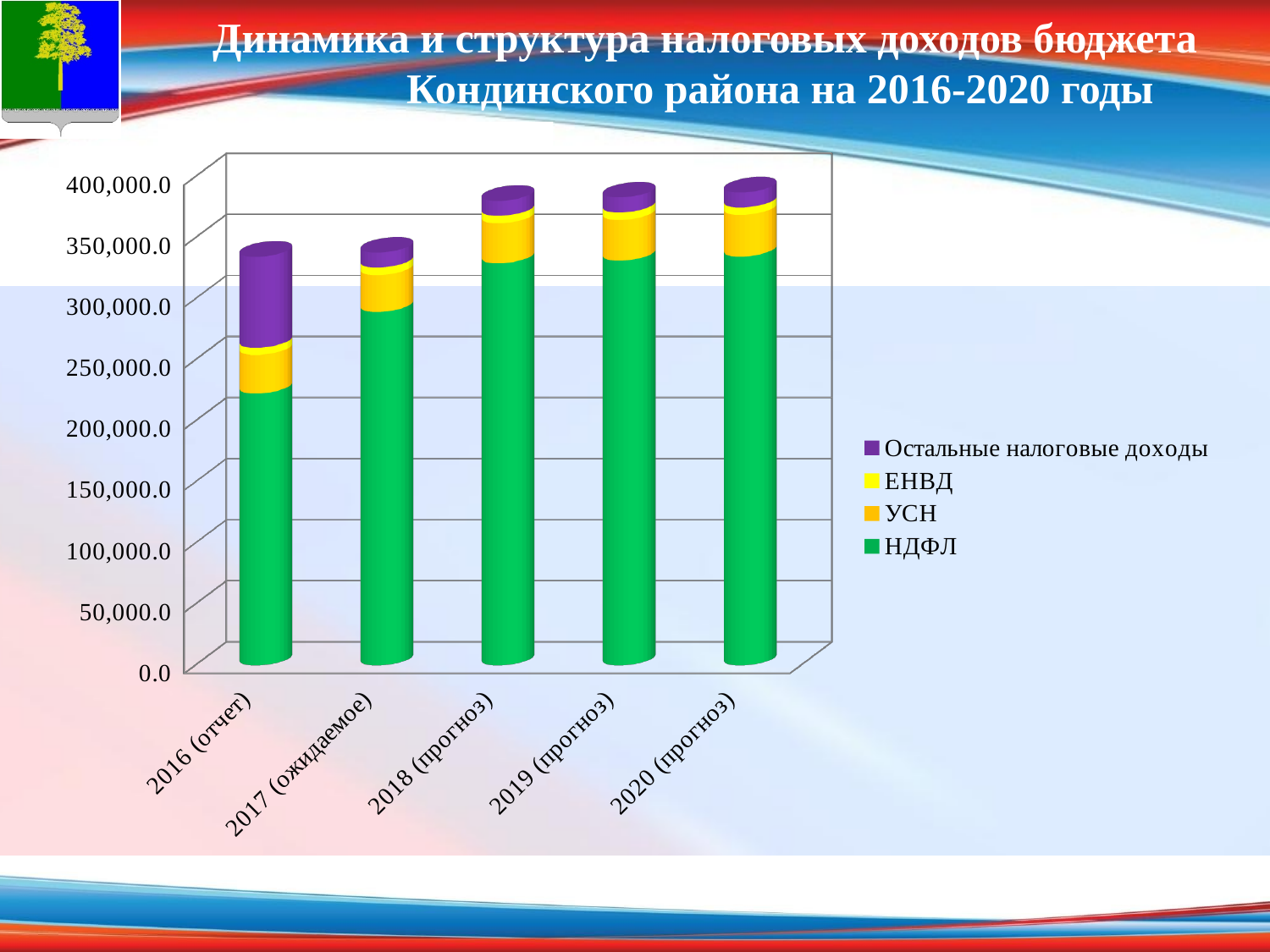
Is the НДФЛ value for 2020 (прогноз) greater or less than 300,000.0? greater Is the НДФЛ value for 2016 (отчет) greater or less than 250,000.0? less What kind of chart is shown on the slide? Stacked bar chart Does the НДФЛ value generally rise or fall from 2016 to 2020? rise Which year has the lowest НДФЛ value? 2016 (отчет) Which series is shown in green in the chart? НДФЛ How many years (categories) are shown on the x axis of the chart? 5 How many series does the chart legend list? 4 Is the total of the stacked bar for 2018 (прогноз) greater or less than 350,000.0? greater Which series is shown in purple at the top of each stacked bar? Остальные налоговые доходы Which is larger, the Остальные налоговые доходы value for 2016 (отчет) or for 2017 (ожидаемое)? 2016 (отчет)